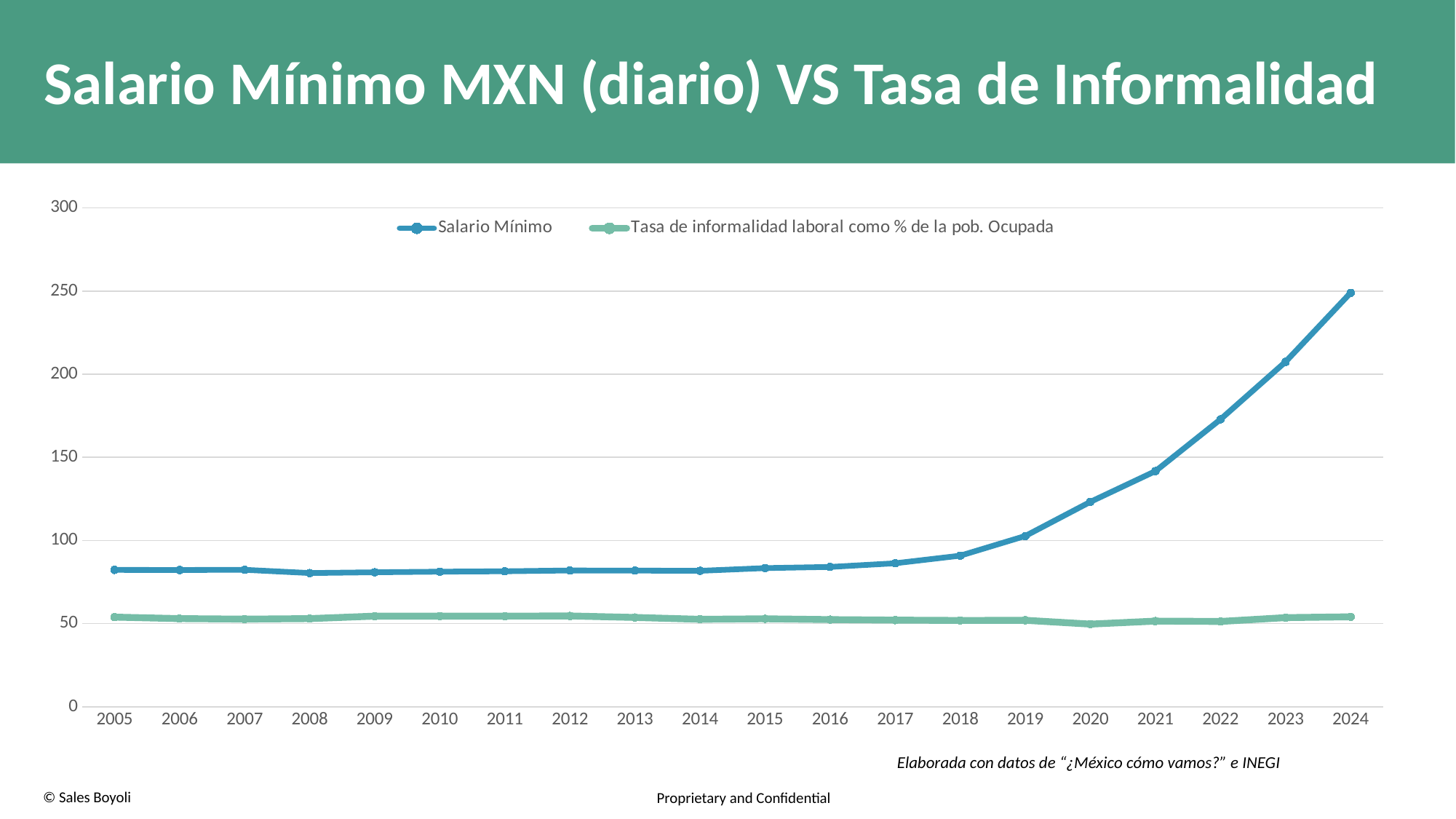
Does the Salario Mínimo series rise or fall from 2018 to 2024? rise How many years are plotted along the x axis? 20 Is the Tasa de informalidad value for 2024 greater or less than 100? less In which year is the Salario Mínimo series at its highest? 2024 How many series does the legend list? 2 Which series has the larger value in 2024, Salario Mínimo or Tasa de informalidad laboral? Salario Mínimo Is the Salario Mínimo value for 2022 greater or less than 150? greater What is the title of the chart on the slide? Salario Mínimo MXN (diario) VS Tasa de Informalidad What kind of chart is shown on the slide? line chart Is the Salario Mínimo value for 2005 greater or less than 100? less